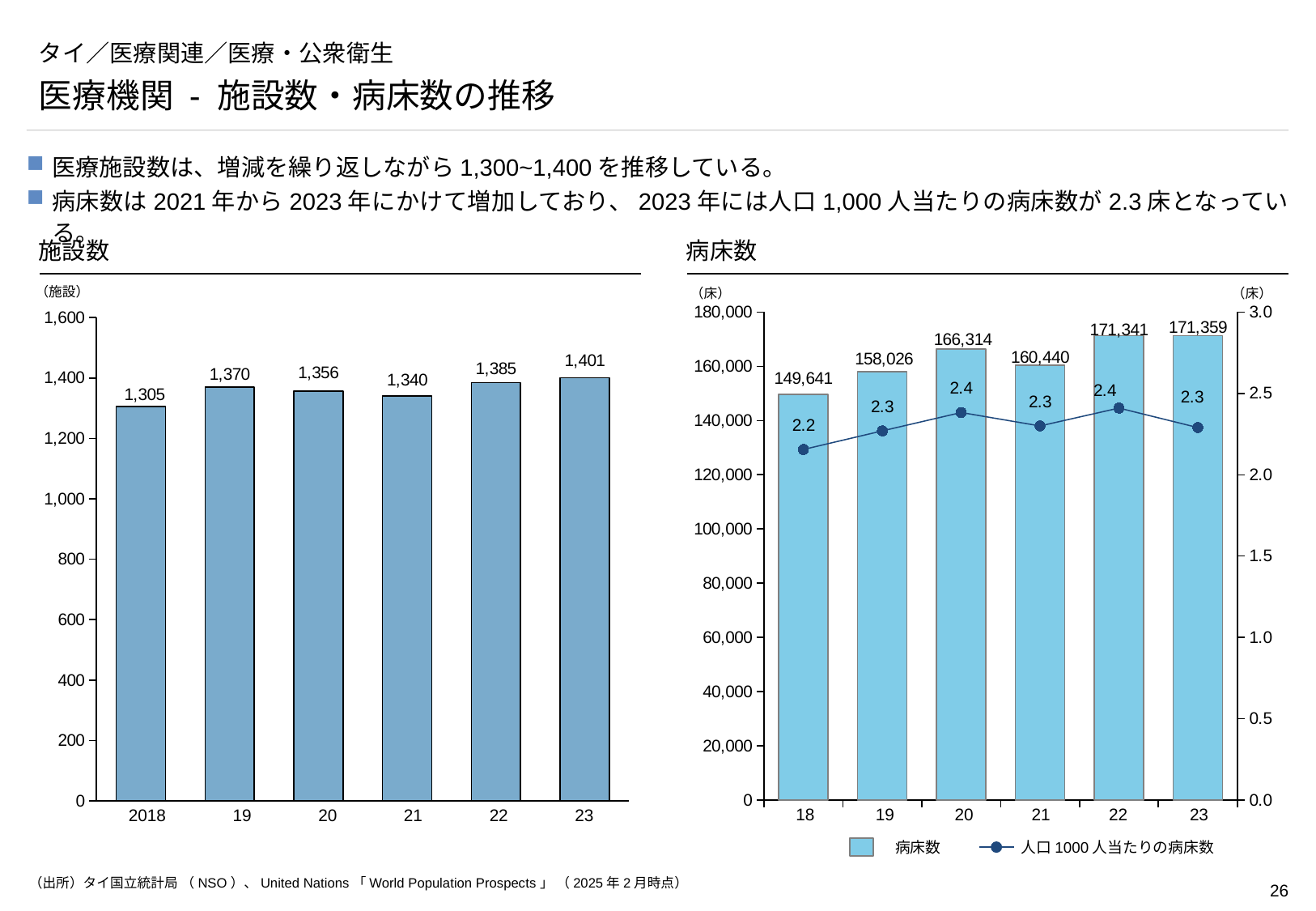
How many series does the legend of the 病床数 chart list? 2 What kind of chart is the 施設数 chart? bar chart In the 施設数 chart, what is the value for 21? 1,340 In the 病床数 chart, which year has the lowest 病床数 value? 18 In the 病床数 chart, what is the 病床数 value for 20? 166,314 In the 施設数 chart, which year has the lowest value? 2018 In the 病床数 chart, what is the 人口1000人当たりの病床数 value for 18? 2.2 In the 病床数 chart, what is the difference between the 病床数 values for 22 and 21? 10,901 In the 施設数 chart, which year has the highest value? 23 In the 施設数 chart, what is the difference between the values for 23 and 2018? 96 In the 施設数 chart, how many bars are plotted? 6 In the 施設数 chart, what is the value for 2018? 1,305